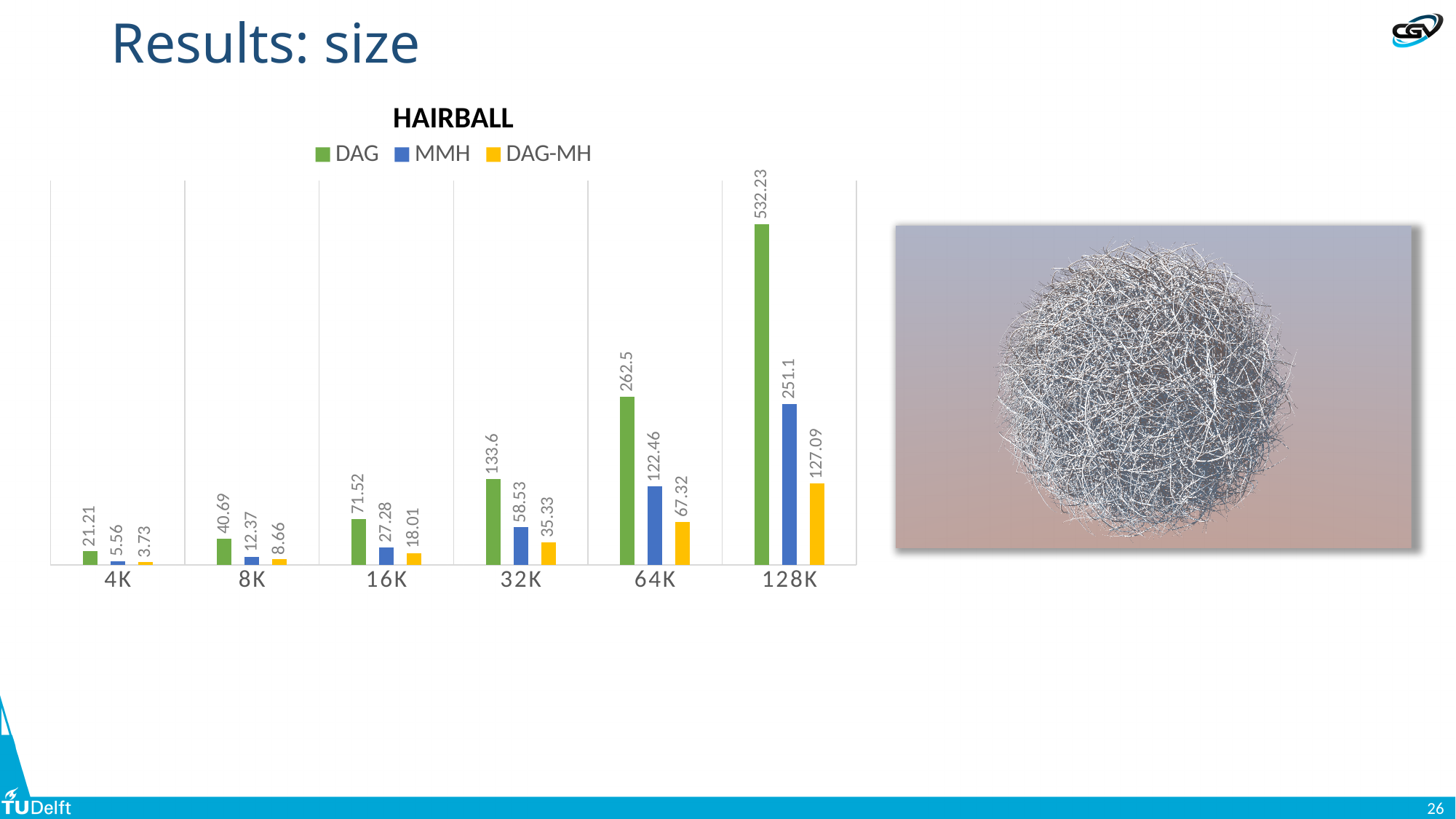
Which category has the highest DAG value? 128K Which is larger for 8K, the MMH value or the DAG-MH value? MMH Do the DAG values rise or fall from 4K to 128K? Rise What is the DAG value for 128K? 532.23 How many categories are shown on the x axis? 6 Which category has the lowest DAG-MH value? 4K What is the difference between the DAG and MMH values for 32K? 75.07 What is the title of the chart? HAIRBALL What kind of chart is shown? Bar chart How many series does the legend list? 3 What is the MMH value for 16K? 27.28 What is the DAG-MH value for 64K? 67.32